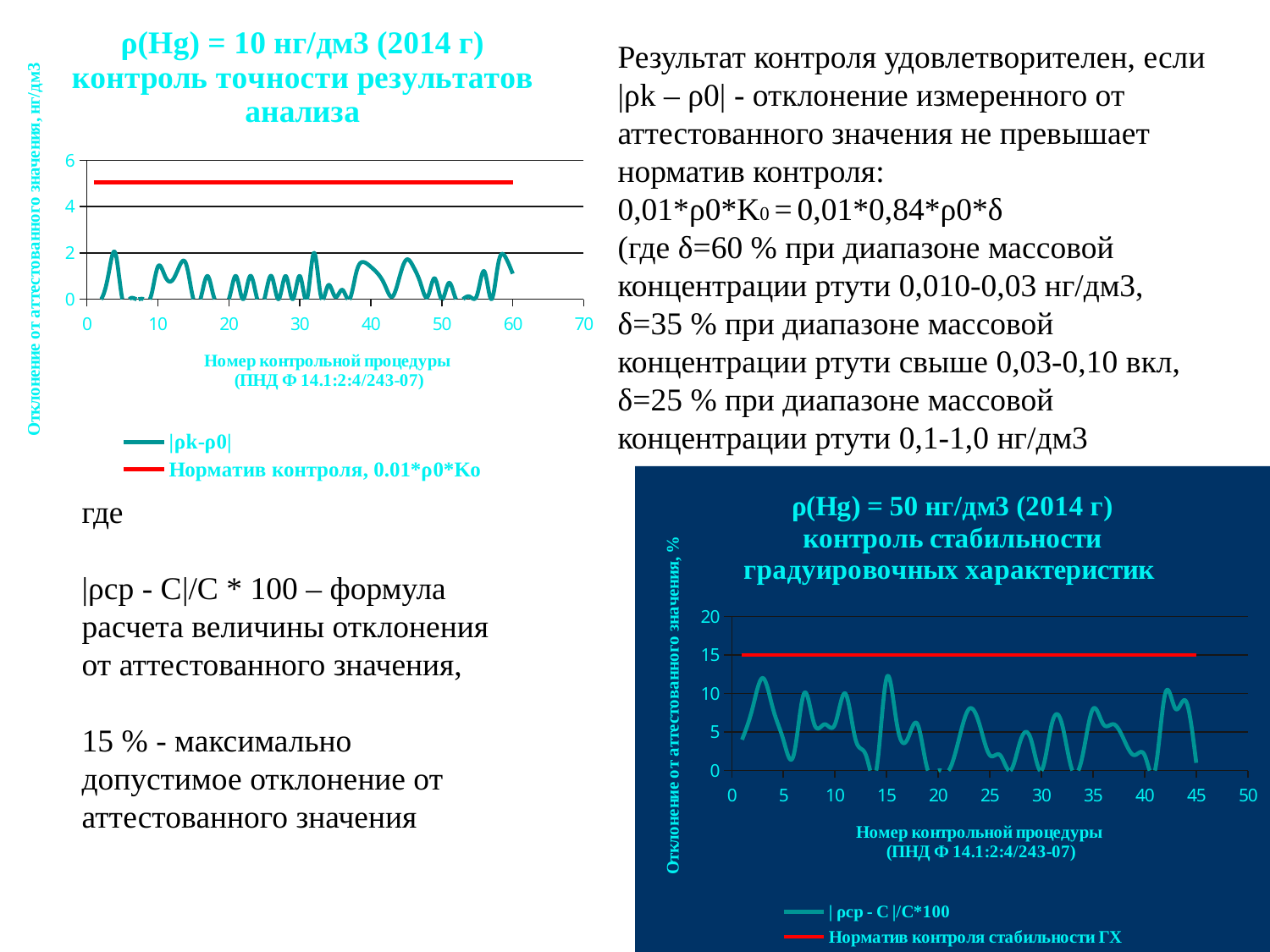
In the bottom-right chart (контроль стабильности градуировочных характеристик), which series is higher across the whole x axis: |ρср - С|/С*100 or Норматив контроля стабильности ГХ? Норматив контроля стабильности ГХ In the top-left chart (контроль точности результатов анализа), is the highest value of the |ρk-ρ0| series greater or less than 4? less What is the x-axis title of the bottom-right chart (контроль стабильности градуировочных характеристик)? Номер контрольной процедуры (ПНД Ф 14.1:2:4/243-07) In the top-left chart (контроль точности результатов анализа), which series is higher across the whole x axis: |ρk-ρ0| or Норматив контроля, 0.01*ρ0*Ko? Норматив контроля, 0.01*ρ0*Ko What kind of chart is the bottom-right chart titled 'ρ(Hg) = 50 нг/дм3 (2014 г) контроль стабильности градуировочных характеристик'? line chart How many series does the legend of the top-left chart (контроль точности результатов анализа) list? 2 In the bottom-right chart (контроль стабильности градуировочных характеристик), is the highest value of the |ρср - С|/С*100 series greater or less than 15? less What kind of chart is the top-left chart titled 'ρ(Hg) = 10 нг/дм3 (2014 г) контроль точности результатов анализа'? line chart What colour is the 'Норматив контроля, 0.01*ρ0*Ko' line in the top-left chart (контроль точности результатов анализа)? red How many series does the legend of the bottom-right chart (контроль стабильности градуировочных характеристик) list? 2 In the bottom-right chart (контроль стабильности градуировочных характеристик), at what value on the y axis does the red 'Норматив контроля стабильности ГХ' line lie? 15